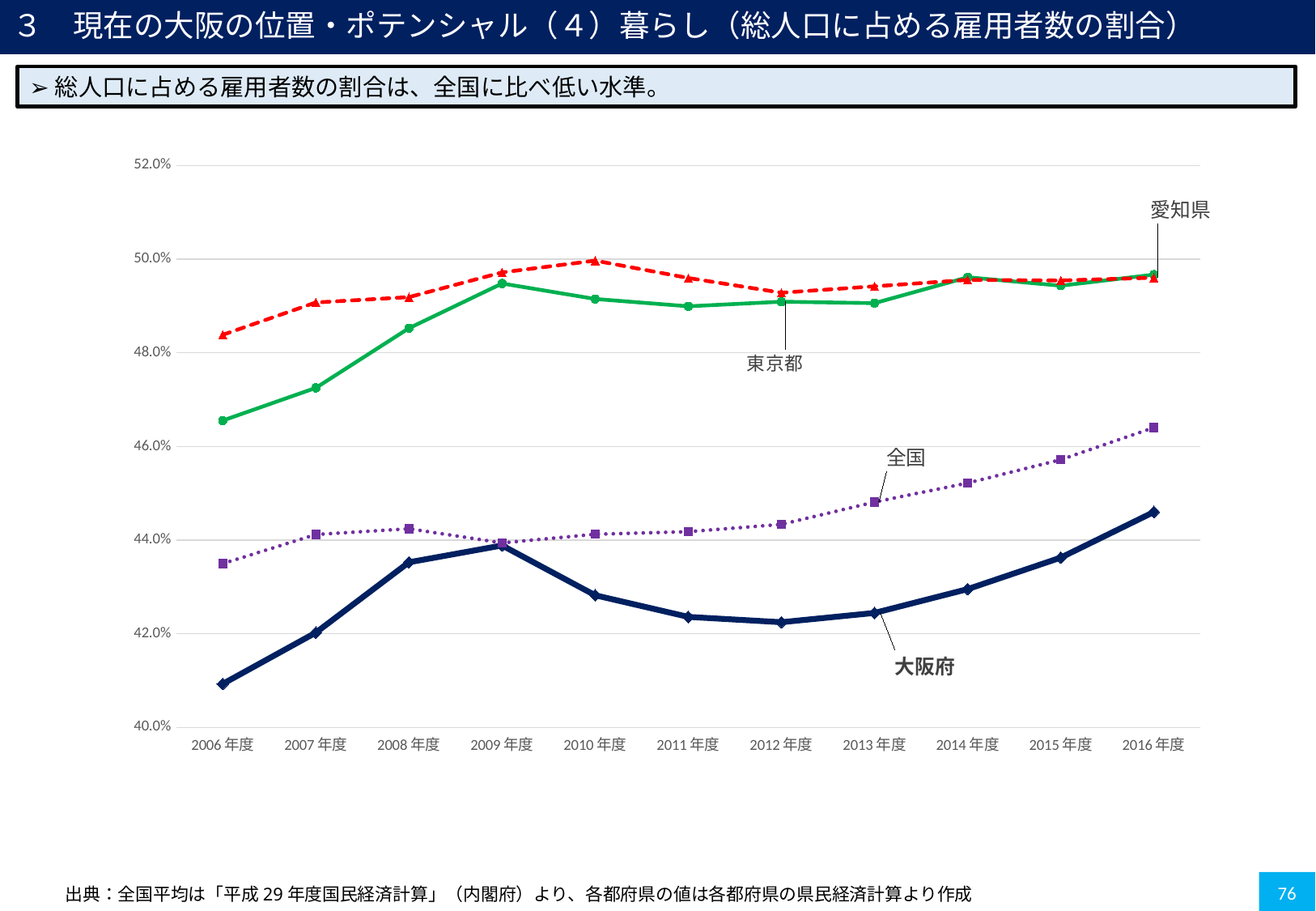
Is the value for 全国 in 2016年度 greater or less than 46.0%? greater How many lines (series) are plotted on the chart? 4 Is the value for 大阪府 in 2006年度 greater or less than 42.0%? less In 2006年度, which is higher, 東京都 or 愛知県? 愛知県 Which series has the lowest value in 2016年度? 大阪府 In which fiscal year does 大阪府 reach its highest value? 2016年度 Is the value for 東京都 in 2009年度 greater or less than 48.0%? greater What kind of chart is shown on the slide? Line chart In 2008年度, which is higher, 全国 or 大阪府? 全国 Does the 全国 line rise or fall from 2009年度 to 2016年度? rise How many fiscal years are shown on the x axis of the chart? 11